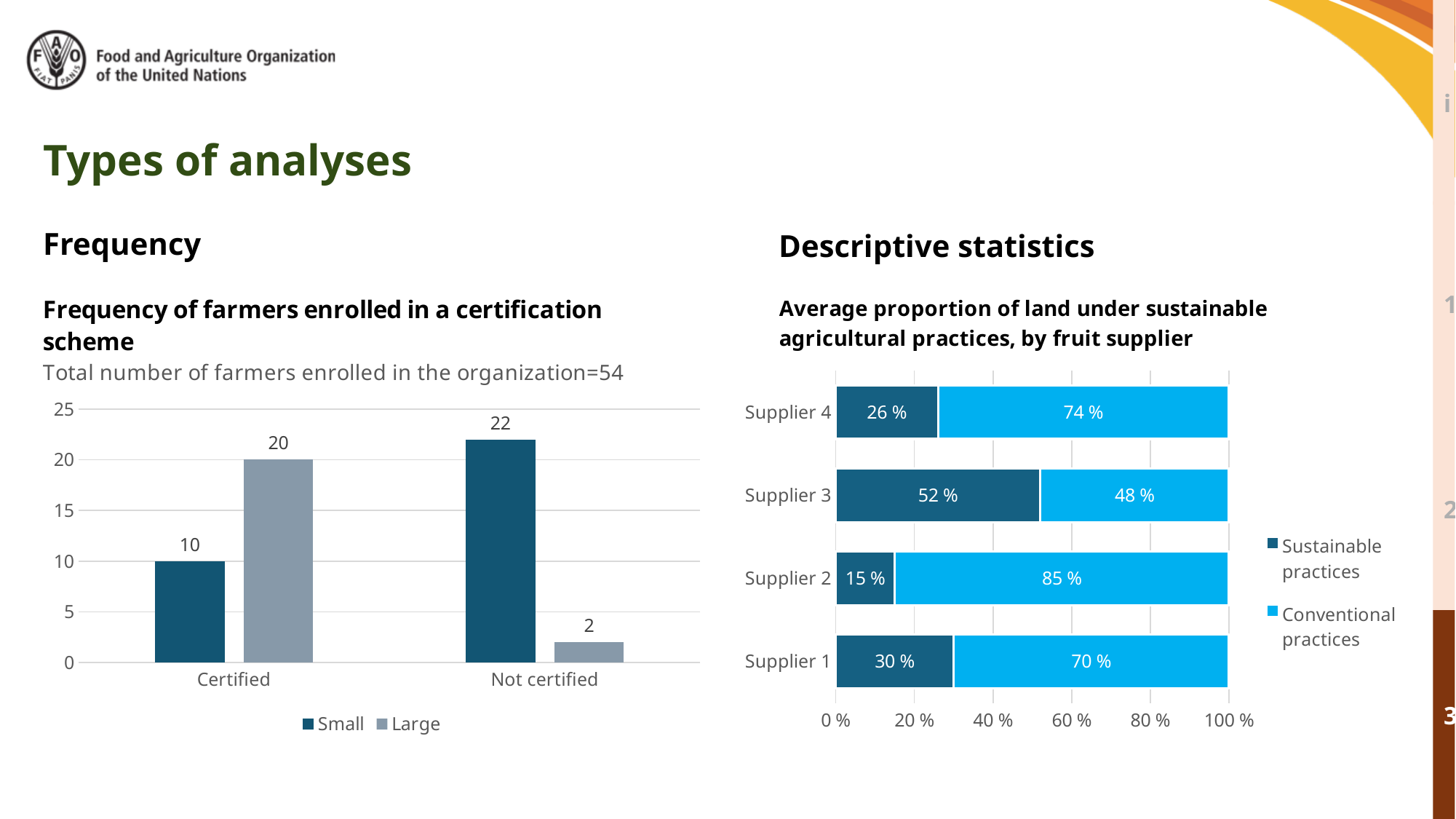
In the 'Average proportion of land under sustainable agricultural practices, by fruit supplier' chart, what is the Sustainable practices value for Supplier 3? 52 % In the 'Frequency of farmers enrolled in a certification scheme' chart, what is the difference between Small and Large farmers in the Not certified category? 20 In the 'Average proportion of land under sustainable agricultural practices, by fruit supplier' chart, which supplier has the highest Sustainable practices value? Supplier 3 In the 'Average proportion of land under sustainable agricultural practices, by fruit supplier' chart, what is the Conventional practices value for Supplier 2? 85 % In the 'Average proportion of land under sustainable agricultural practices, by fruit supplier' chart, how many suppliers are shown? 4 What kind of chart is the 'Frequency of farmers enrolled in a certification scheme' chart? Bar chart In the 'Average proportion of land under sustainable agricultural practices, by fruit supplier' chart, which supplier has the lowest Sustainable practices value? Supplier 2 In the 'Frequency of farmers enrolled in a certification scheme' chart, what is the value for Large farmers who are Not certified? 2 In the 'Frequency of farmers enrolled in a certification scheme' chart, what is the value for Small farmers who are Certified? 10 In the 'Frequency of farmers enrolled in a certification scheme' chart, which is larger for Certified farmers: Small or Large? Large In the 'Frequency of farmers enrolled in a certification scheme' chart, how many series does the legend list? 2 In the 'Average proportion of land under sustainable agricultural practices, by fruit supplier' chart, what is the difference between the Conventional practices values of Supplier 4 and Supplier 1? 4 %